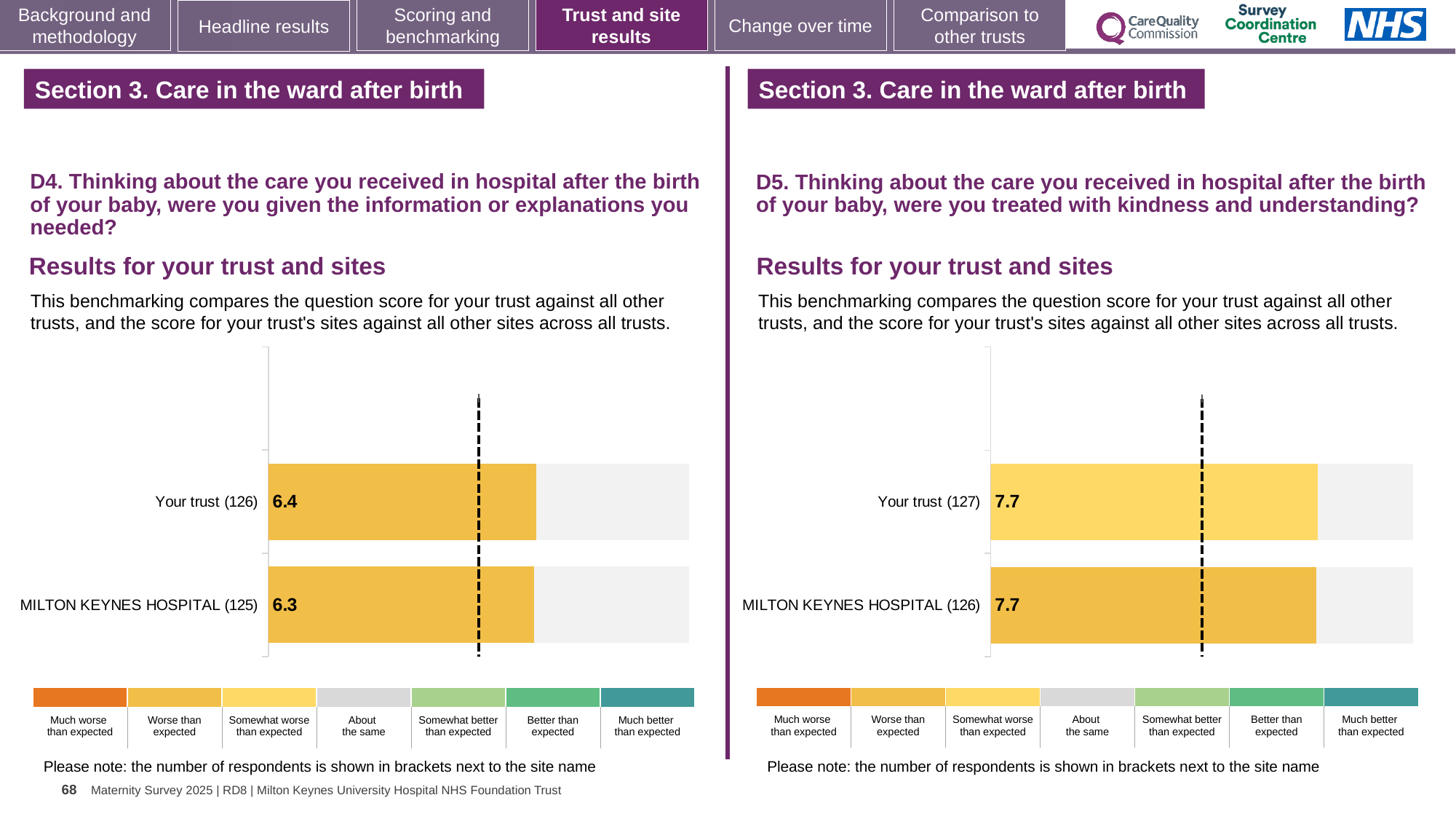
What type of chart is used in the D4 chart on the left? Bar chart In the D4 chart on the left, what is the score for MILTON KEYNES HOSPITAL (125)? 6.3 In the D5 chart on the right, what is the score for MILTON KEYNES HOSPITAL (126)? 7.7 How many bars are plotted in the D5 chart on the right? 2 In the D4 chart on the left, what is the score for Your trust (126)? 6.4 In the D5 chart on the right, what is the score for Your trust (127)? 7.7 How many bars are plotted in the D4 chart on the left? 2 In the D4 chart on the left, which has the higher score, Your trust or MILTON KEYNES HOSPITAL? Your trust In the D4 chart on the left, what is the difference between the score for Your trust and the score for MILTON KEYNES HOSPITAL? 0.1 In the D5 chart on the right, what is the difference between the score for Your trust and the score for MILTON KEYNES HOSPITAL? 0 How many respondents are shown in brackets for Your trust in the D5 chart on the right? 127 How many categories does the colour key below the D4 chart on the left list? 7